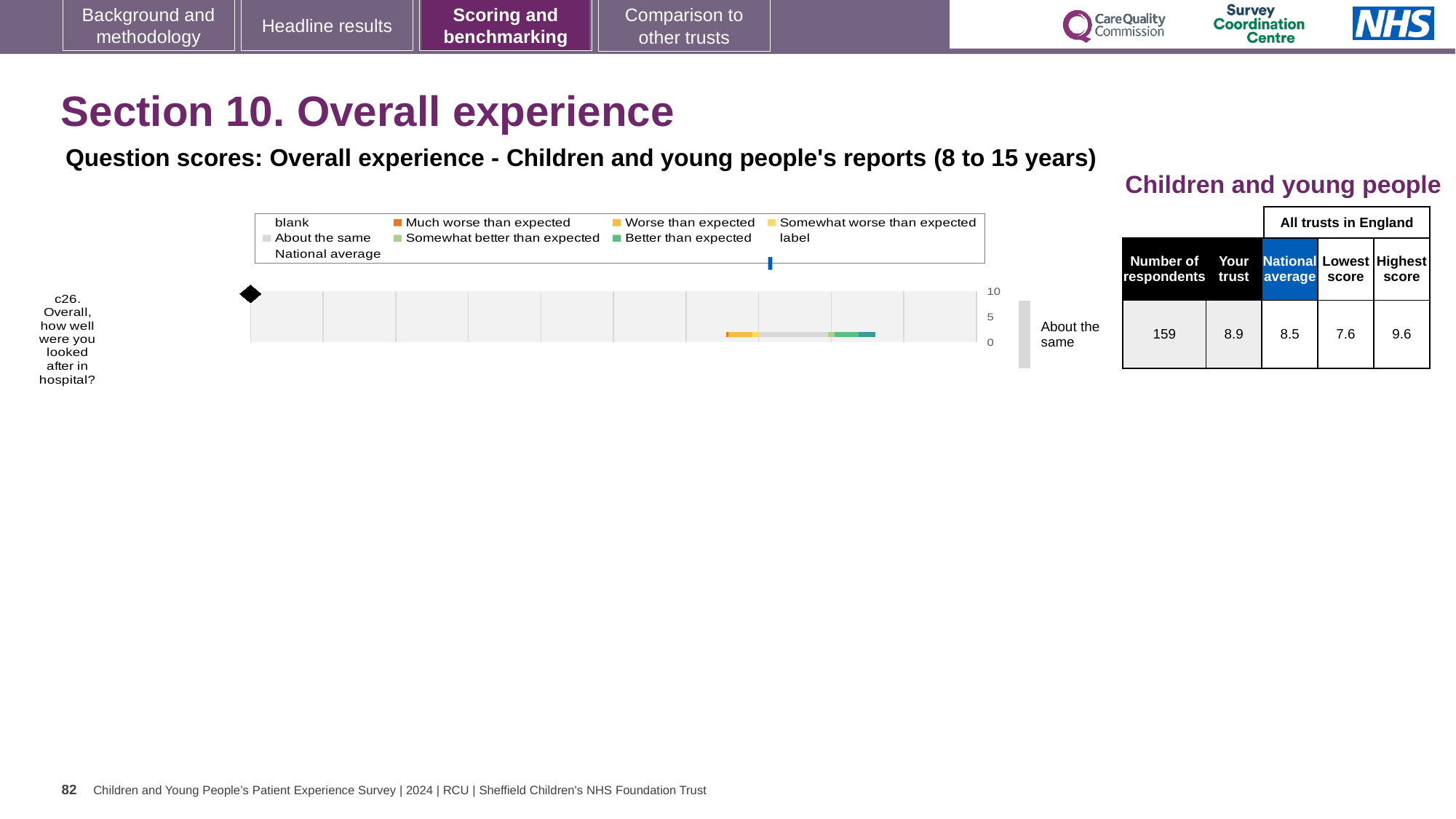
What kind of chart is shown on the slide? bar chart What benchmark category is shown next to the bar for question c26? About the same Which question is plotted in the chart? c26. Overall, how well were you looked after in hospital? What is the difference between the 'Your trust' score and the national average for question c26? 0.4 Which is larger for question c26, the 'Your trust' score or the national average? Your trust What is the 'Your trust' score for question c26? 8.9 How many survey questions are plotted in the chart? 1 What is the maximum value shown on the chart's score axis? 10 What is the highest score among all trusts in England for question c26? 9.6 What is the lowest score among all trusts in England for question c26? 7.6 What is the national average score for question c26? 8.5 How many respondents answered question c26? 159